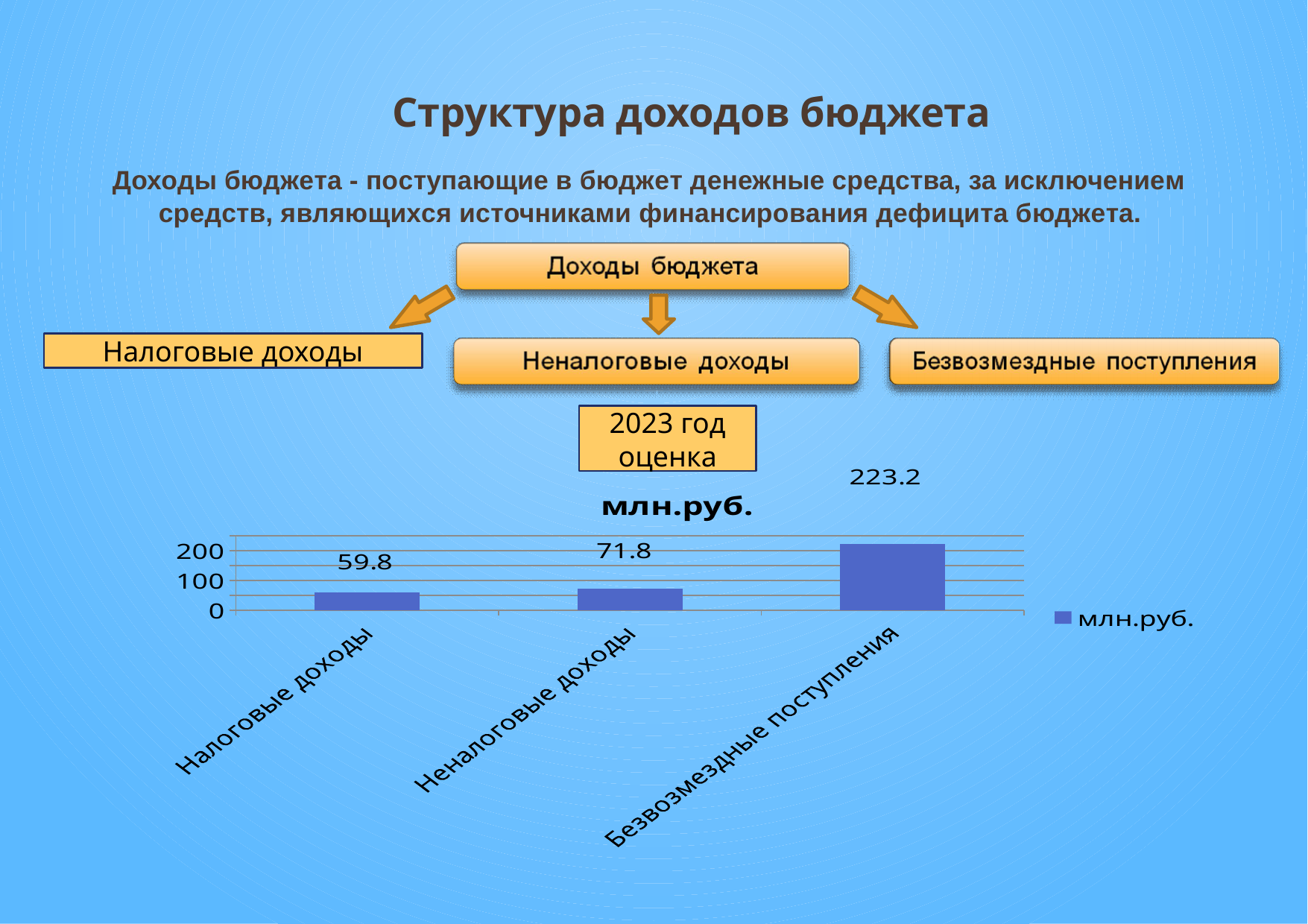
What is the value for Налоговые доходы? 59.8 What is the value for Неналоговые доходы? 71.8 Which is larger, Налоговые доходы or Неналоговые доходы? Неналоговые доходы Is the value for Безвозмездные поступления greater or less than 200? greater Which category has the highest value? Безвозмездные поступления What is the title of the chart? млн.руб. What is the difference between Безвозмездные поступления and Неналоговые доходы? 151.4 What is the difference between Неналоговые доходы and Налоговые доходы? 12 How many categories are shown in the chart? 3 Which category has the lowest value? Налоговые доходы What kind of chart is shown on the slide? bar chart What is the value for Безвозмездные поступления? 223.2